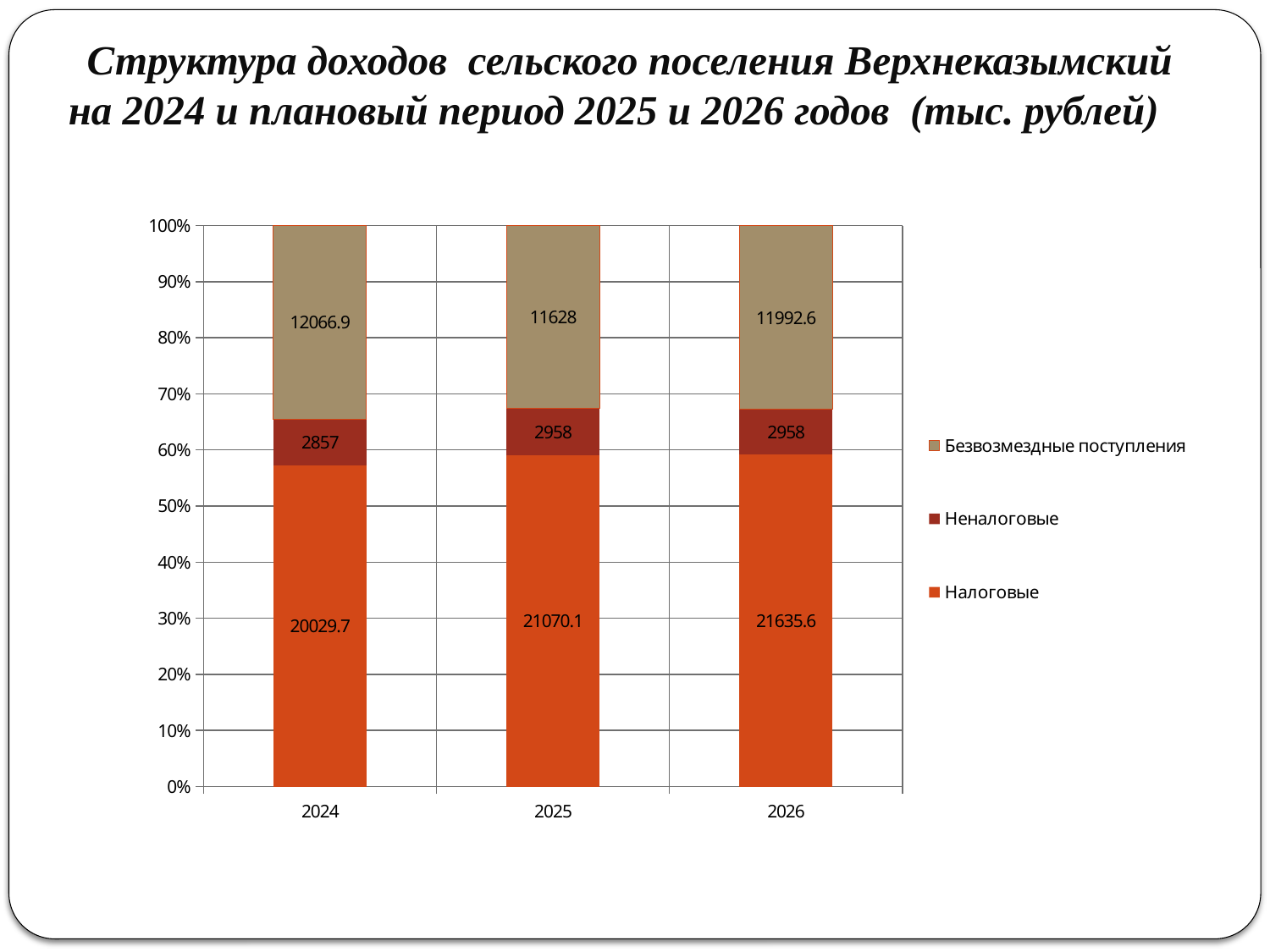
In which year is the Налоговые value highest? 2026 What kind of chart is shown on the slide? Stacked bar chart What is the value of Налоговые for 2024? 20029.7 In which year is the Безвозмездные поступления value lowest? 2025 Which is larger: Безвозмездные поступления for 2024 or for 2026? 2024 What is the value of Неналоговые for 2026? 2958 What is the total of the stacked bar for 2025? 35656.1 What is the value of Безвозмездные поступления for 2025? 11628 How many years are shown on the x axis? 3 What is the difference between the Налоговые values for 2026 and 2024? 1605.9 What is the difference between the Безвозмездные поступления values for 2024 and 2025? 438.9 How many series does the legend list? 3